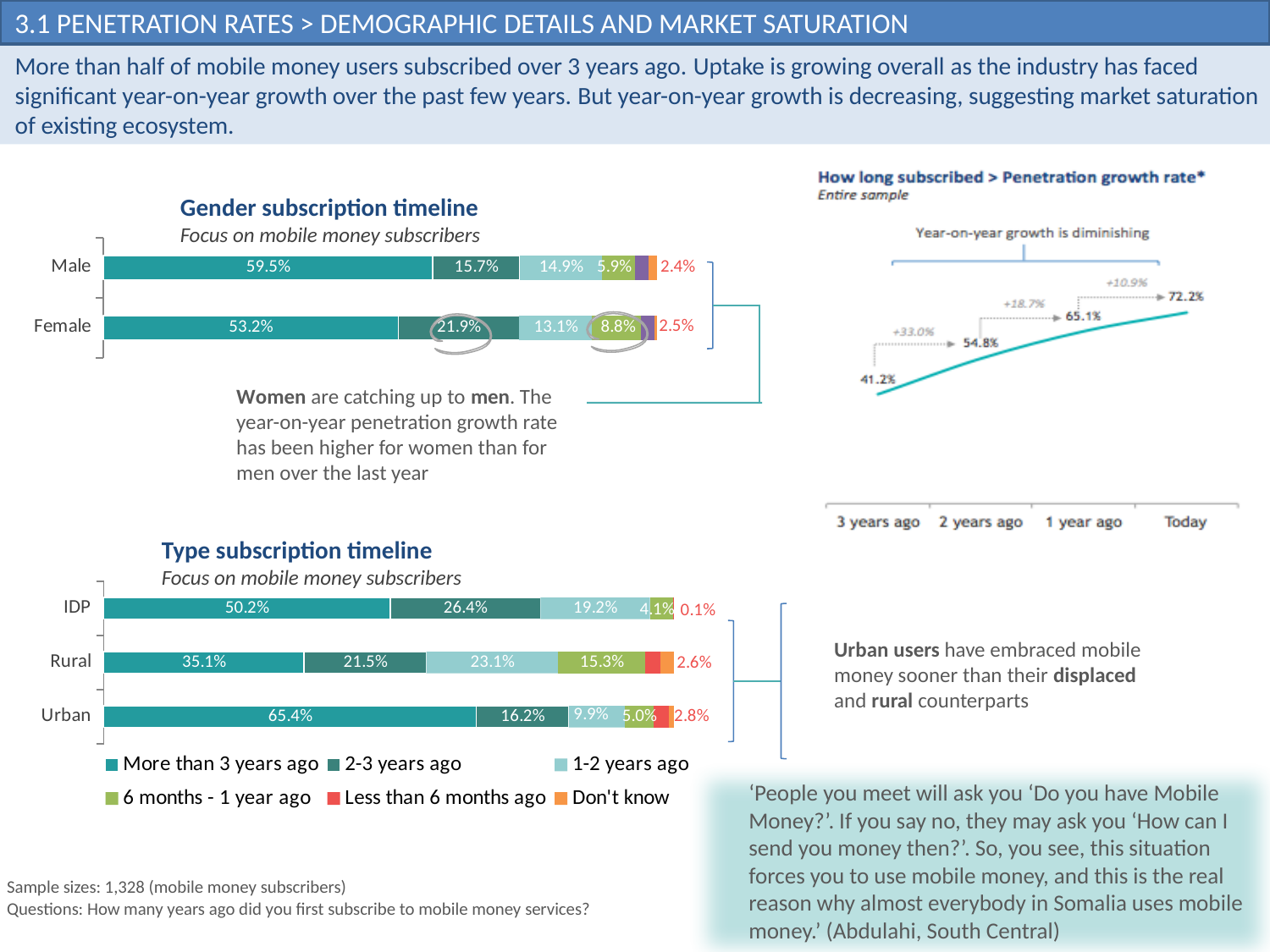
In the Type subscription timeline chart, what is the 2-3 years ago value for IDP? 26.4% In the Type subscription timeline chart, which category has the lowest 'More than 3 years ago' share? Rural In the Type subscription timeline chart, what is the 'More than 3 years ago' value for Urban? 65.4% In the Gender subscription timeline chart, what percentage of male subscribers subscribed more than 3 years ago? 59.5% In the Gender subscription timeline chart, what is the value for Female in the 2-3 years ago segment? 21.9% In the Type subscription timeline chart, which is larger for the 1-2 years ago segment: Rural or Urban? Rural How many categories are shown in the Type subscription timeline chart? 3 In the Gender subscription timeline chart, what is the difference between the Male and Female values for the 'More than 3 years ago' segment? 6.3 percentage points What kind of chart is the Type subscription timeline chart? Stacked bar chart In the 'How long subscribed > Penetration growth rate' chart, what is the value for Today? 72.2% In the 'How long subscribed > Penetration growth rate' chart, do the values rise or fall from 3 years ago to Today? Rise How many series does the legend of the Type subscription timeline chart list? 6